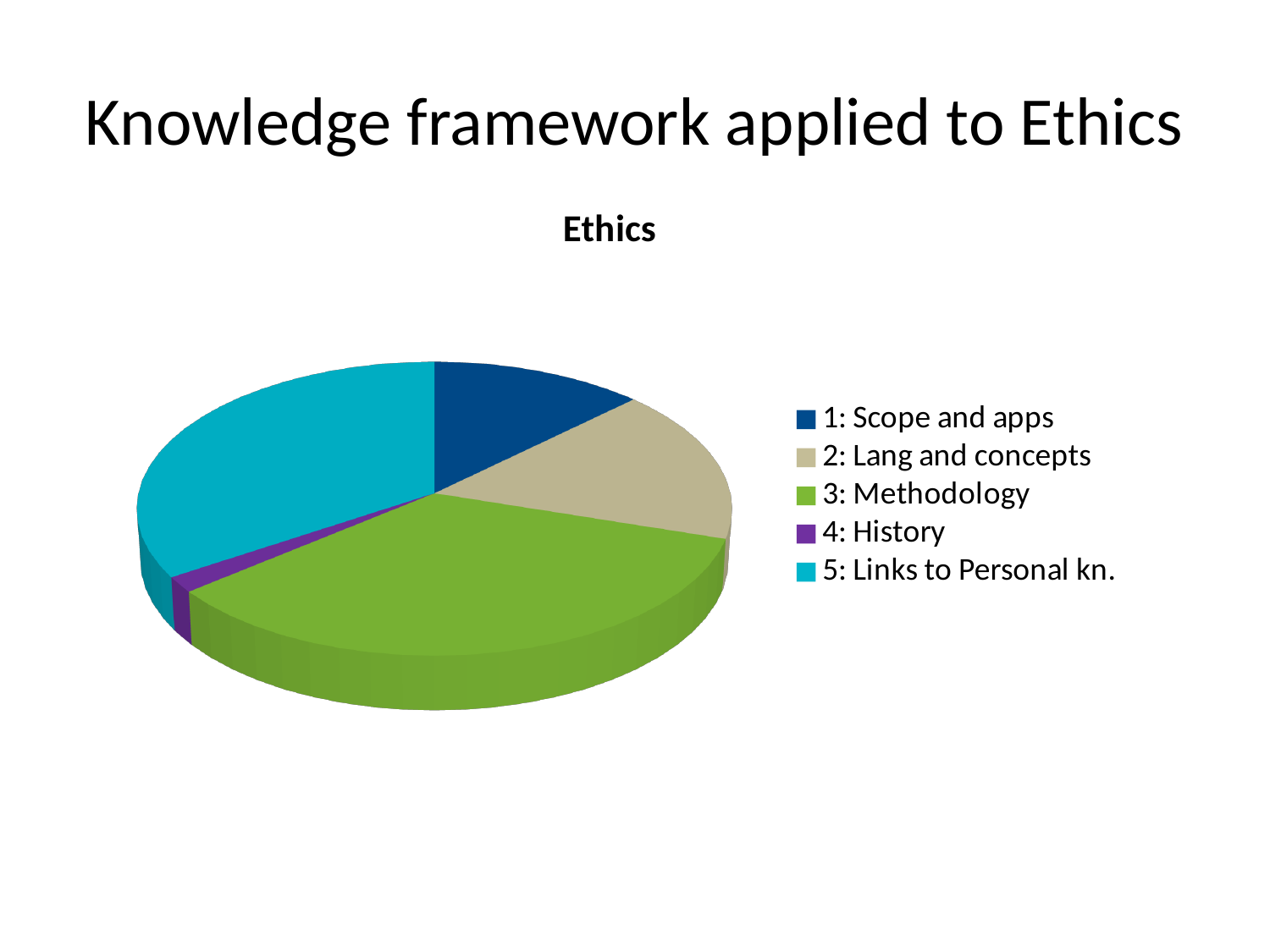
What colour is the slice for 3: Methodology? Green What kind of chart is shown on the slide? Pie chart Which slice is larger, 5: Links to Personal kn. or 4: History? 5: Links to Personal kn. How many entries does the legend list? 5 What is the title of the chart? Ethics How many slices does the pie chart have? 5 Which slice is larger, 2: Lang and concepts or 4: History? 2: Lang and concepts Which slice is larger, 3: Methodology or 4: History? 3: Methodology Which category has the smallest slice of the pie? 4: History